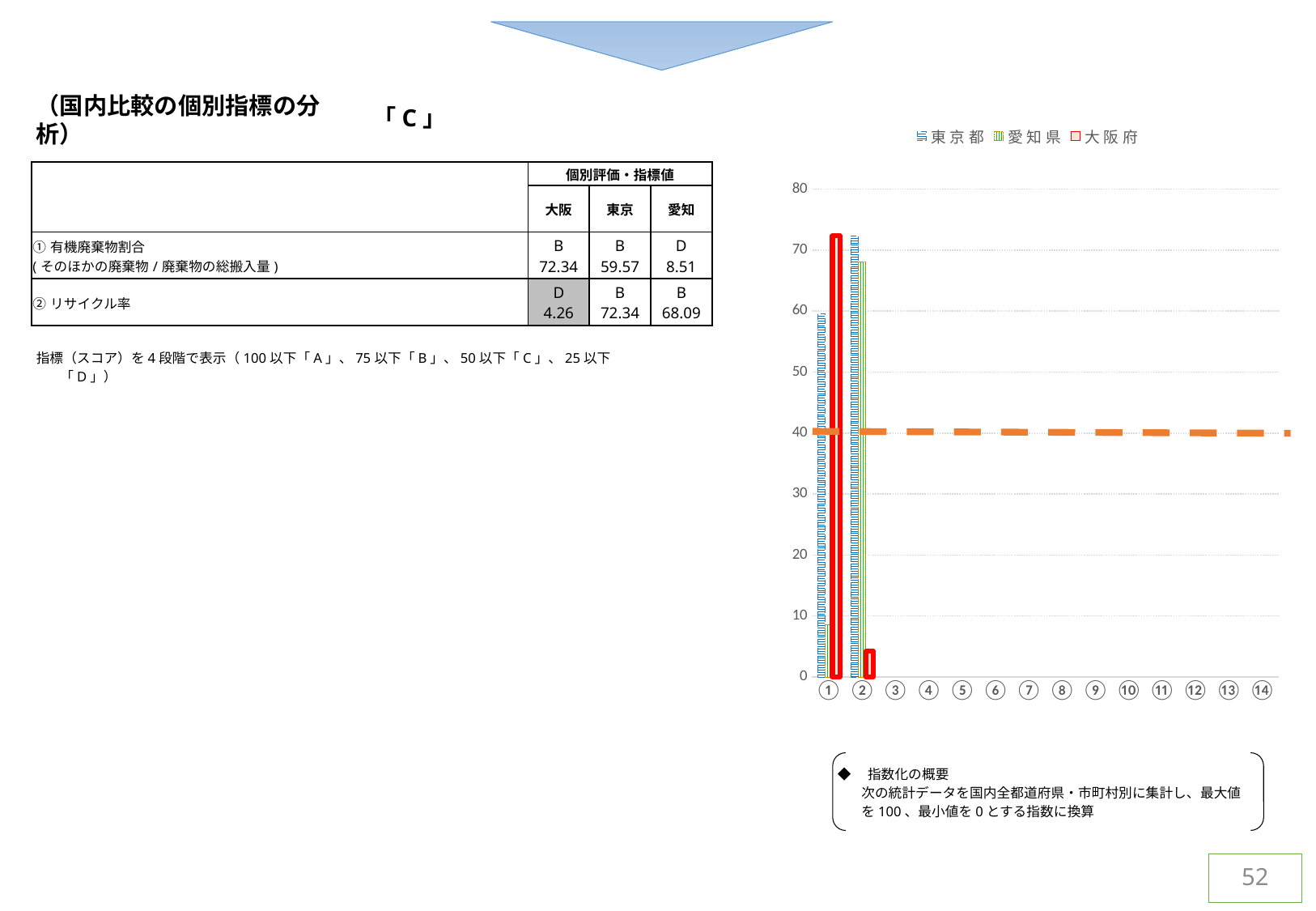
Is the value for 大阪府 at category ② greater or less than 10? less How many categories are shown along the x axis of the chart? 14 Is the value for 愛知県 at category ② greater or less than 60? greater Is the value for 大阪府 at category ① greater or less than 60? greater At category ①, which series has the larger value, 大阪府 or 愛知県? 大阪府 At category ②, which series has the larger value, 東京都 or 大阪府? 東京都 At what value on the y axis is the horizontal dashed line drawn across the chart? 40 Which series has the highest value at category ①? 大阪府 How many series does the chart legend list? 3 What kind of chart is shown on the right side of the slide? bar chart